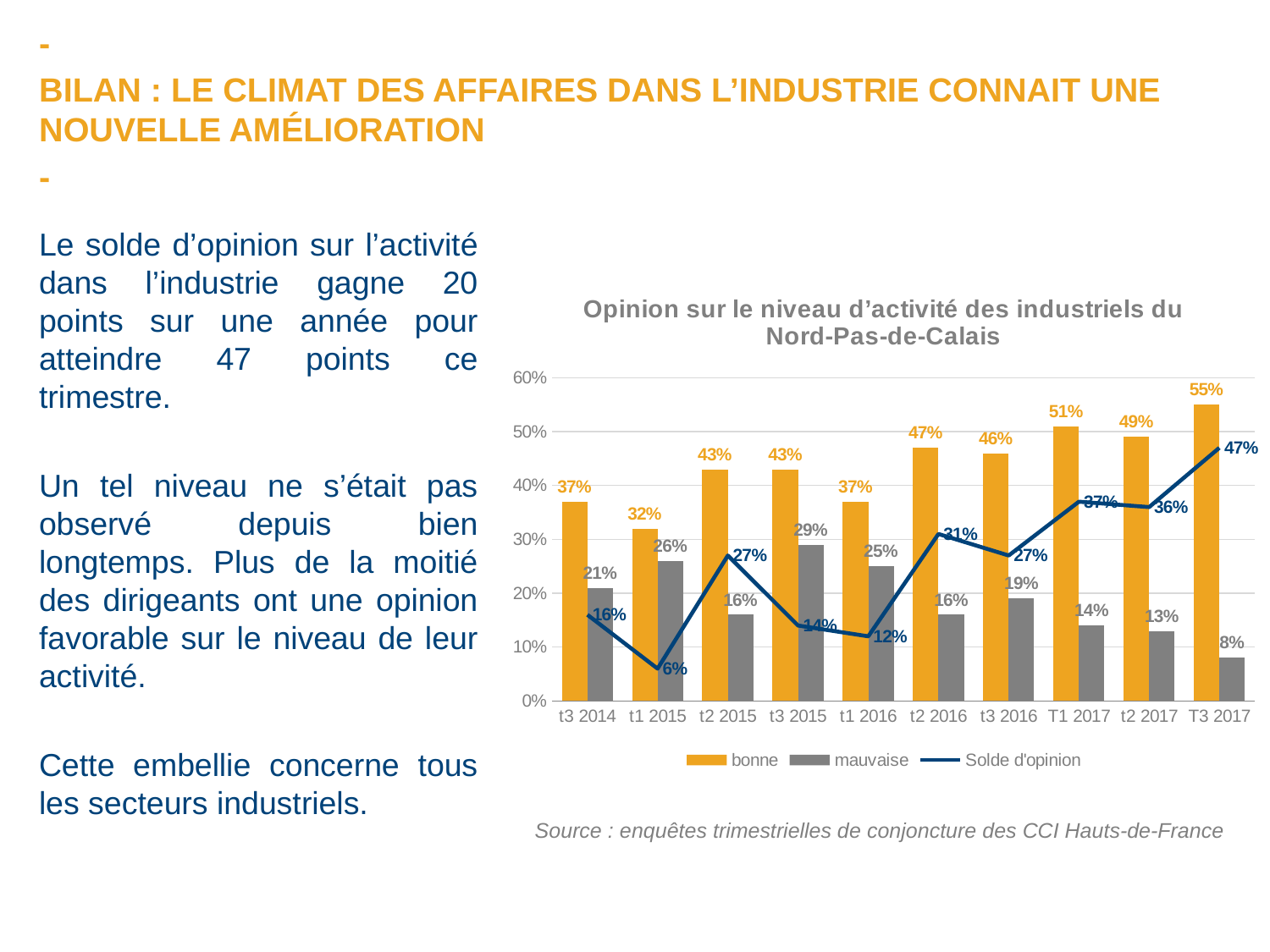
What is the title of the chart? Opinion sur le niveau d'activité des industriels du Nord-Pas-de-Calais Which period has the highest value for the 'bonne' series? T3 2017 What is the value of the 'mauvaise' series for t3 2015? 29% How many periods are shown on the x axis of the chart? 10 What is the value of 'Solde d'opinion' for t1 2015? 6% Which period has the lowest value for the 'mauvaise' series? T3 2017 What is the difference between the 'bonne' and 'mauvaise' values for t2 2016? 31% How many series does the legend list? 3 Is the 'bonne' value for T1 2017 greater or less than 50%? greater Which is larger for t1 2015: the 'bonne' value or the 'mauvaise' value? bonne What kind of chart is shown on the slide? Combined bar and line chart What is the value of the 'bonne' series for T3 2017? 55%